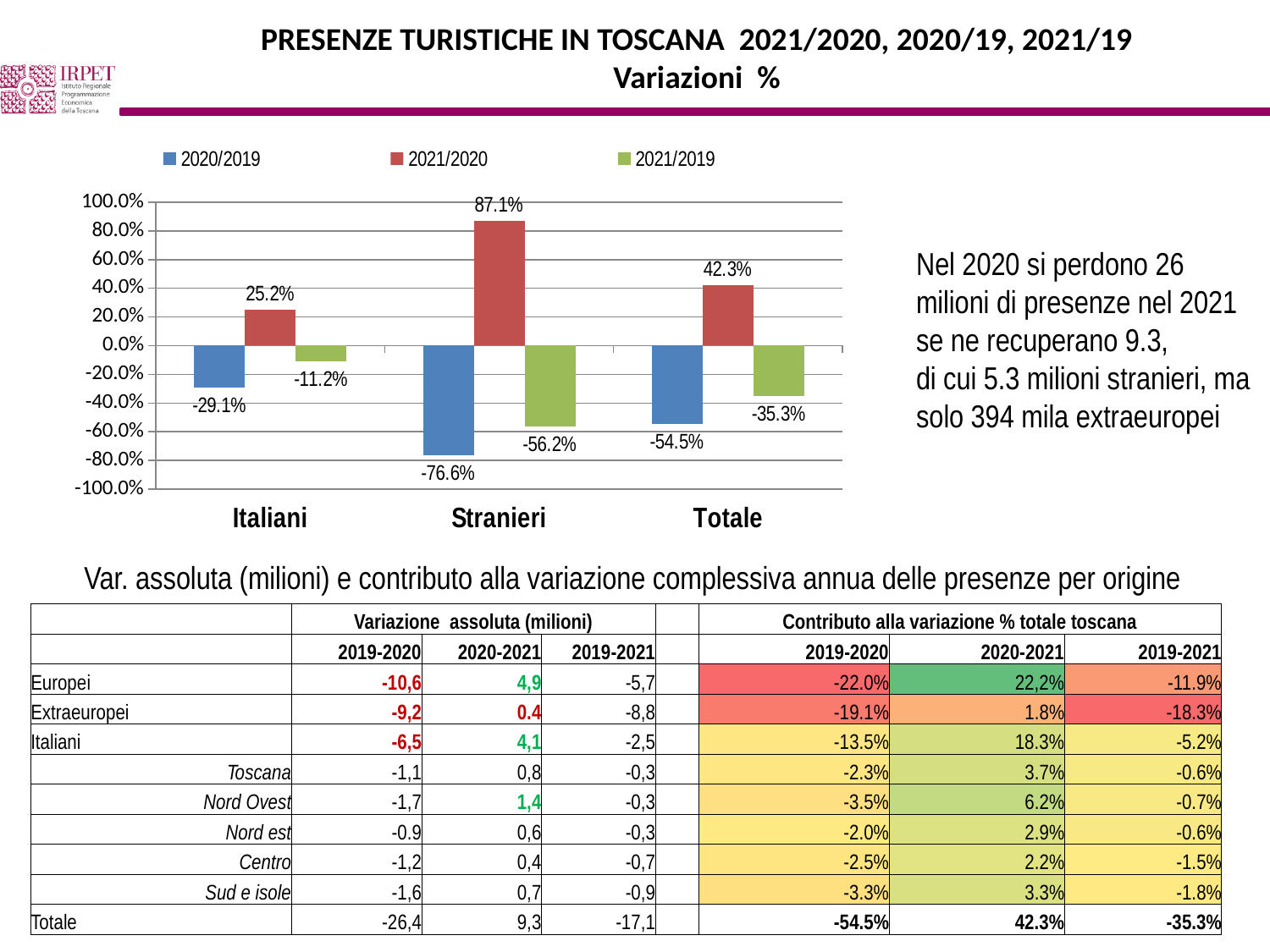
What is the 2020/2019 value for Italiani? -29.1% What is the difference between the 2021/2020 values for Stranieri and Totale? 44.8 percentage points Which series is shown in red in the chart? 2021/2020 How many series does the chart legend list? 3 Which category has the highest 2021/2020 value? Stranieri How many categories are shown on the x axis of the chart? 3 What is the 2021/2020 value for Italiani? 25.2% What is the 2021/2020 value for Stranieri? 87.1% Which is larger, the 2021/2019 value for Italiani or for Stranieri? Italiani What kind of chart is shown on the slide? Bar chart What is the 2021/2019 value for Totale? -35.3% Which category has the lowest 2020/2019 value? Stranieri